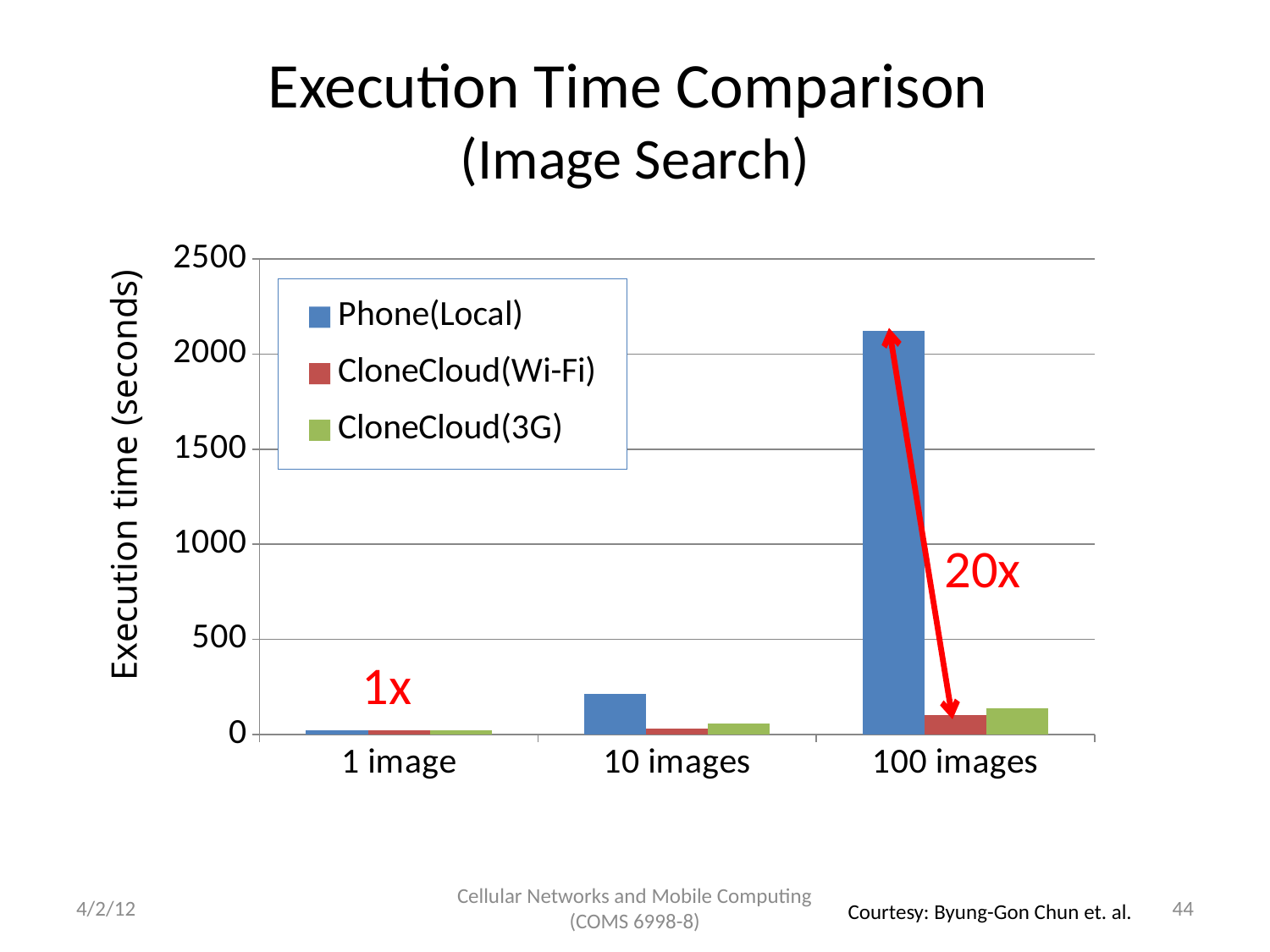
Is the CloneCloud(3G) execution time for 100 images greater or less than 500 seconds? less For 10 images, which is larger: the execution time for Phone(Local) or for CloneCloud(Wi-Fi)? Phone(Local) How many series does the legend list? 3 What is the label of the y axis? Execution time (seconds) For 100 images, which is larger: the execution time for CloneCloud(Wi-Fi) or for CloneCloud(3G)? CloneCloud(3G) Is the Phone(Local) execution time for 10 images greater or less than 500 seconds? less How many categories are shown on the x axis? 3 Does the Phone(Local) execution time rise or fall as the number of images increases from 1 to 100? rise Is the Phone(Local) execution time for 100 images greater or less than 2000 seconds? greater Which series has the lowest execution time for 100 images? CloneCloud(Wi-Fi) What kind of chart is shown on the slide? bar chart Which series has the highest execution time for 100 images? Phone(Local)